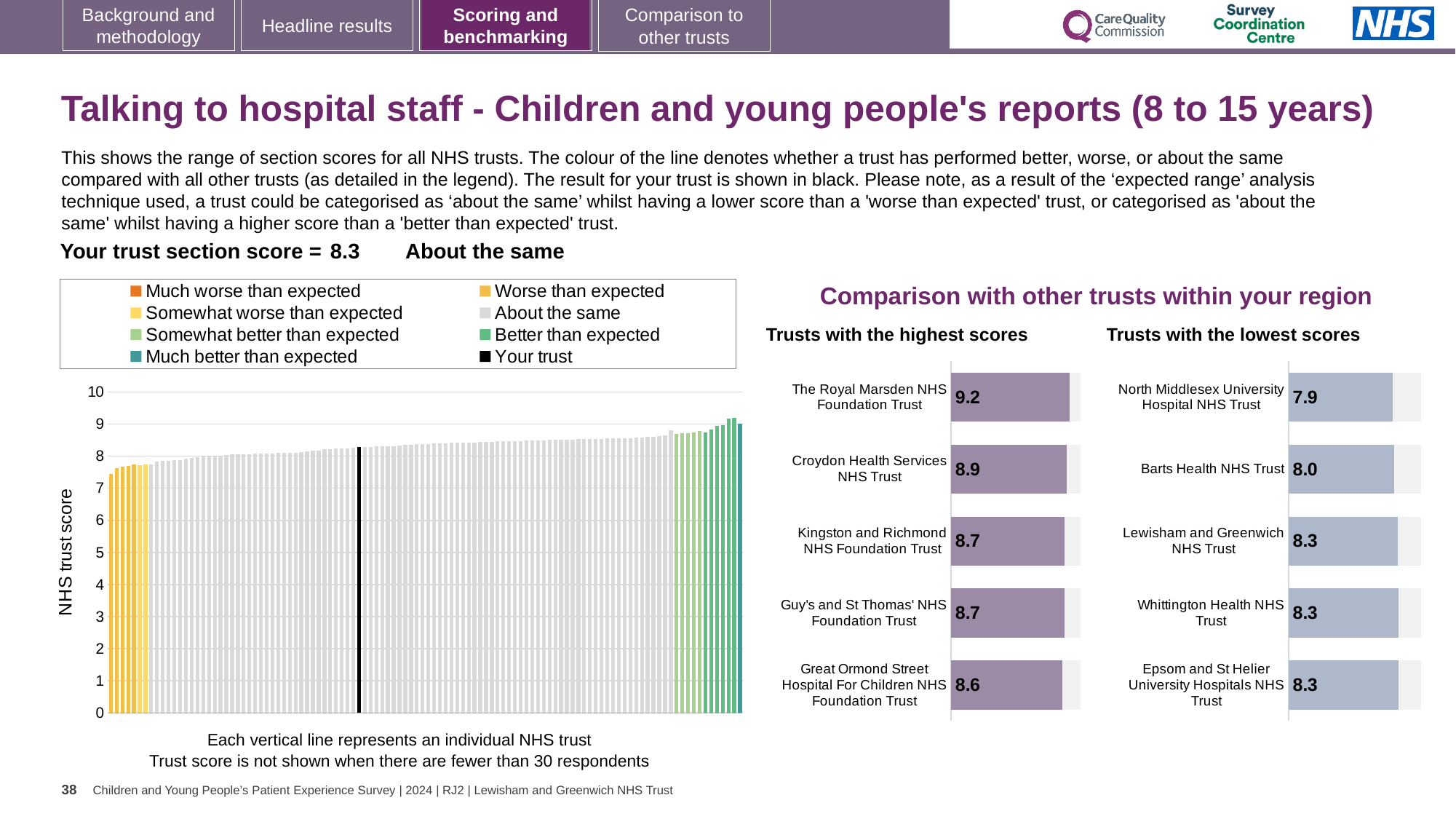
How many entries does the legend above the 'NHS trust score' chart list? 8 In the 'NHS trust score' chart on the left, do the values rise or fall from left to right? Rise How many trusts are shown in the 'Trusts with the lowest scores' chart? 5 What kind of chart is the 'NHS trust score' chart on the left of the slide? Bar chart In the 'Trusts with the highest scores' chart, what is the score for The Royal Marsden NHS Foundation Trust? 9.2 In the 'Trusts with the highest scores' chart, which trust has the highest score? The Royal Marsden NHS Foundation Trust In the 'Trusts with the lowest scores' chart, which trust has the lowest score? North Middlesex University Hospital NHS Trust In the 'Trusts with the lowest scores' chart, what is the difference between the scores of Barts Health NHS Trust and North Middlesex University Hospital NHS Trust? 0.1 In the 'Trusts with the highest scores' chart, which has the higher score: Croydon Health Services NHS Trust or Kingston and Richmond NHS Foundation Trust? Croydon Health Services NHS Trust In the 'NHS trust score' chart on the left, is the value for the black 'Your trust' bar greater or less than 5? greater In the 'Trusts with the lowest scores' chart, what is the score for North Middlesex University Hospital NHS Trust? 7.9 In the 'Trusts with the highest scores' chart, what is the difference between the scores of The Royal Marsden NHS Foundation Trust and Great Ormond Street Hospital For Children NHS Foundation Trust? 0.6